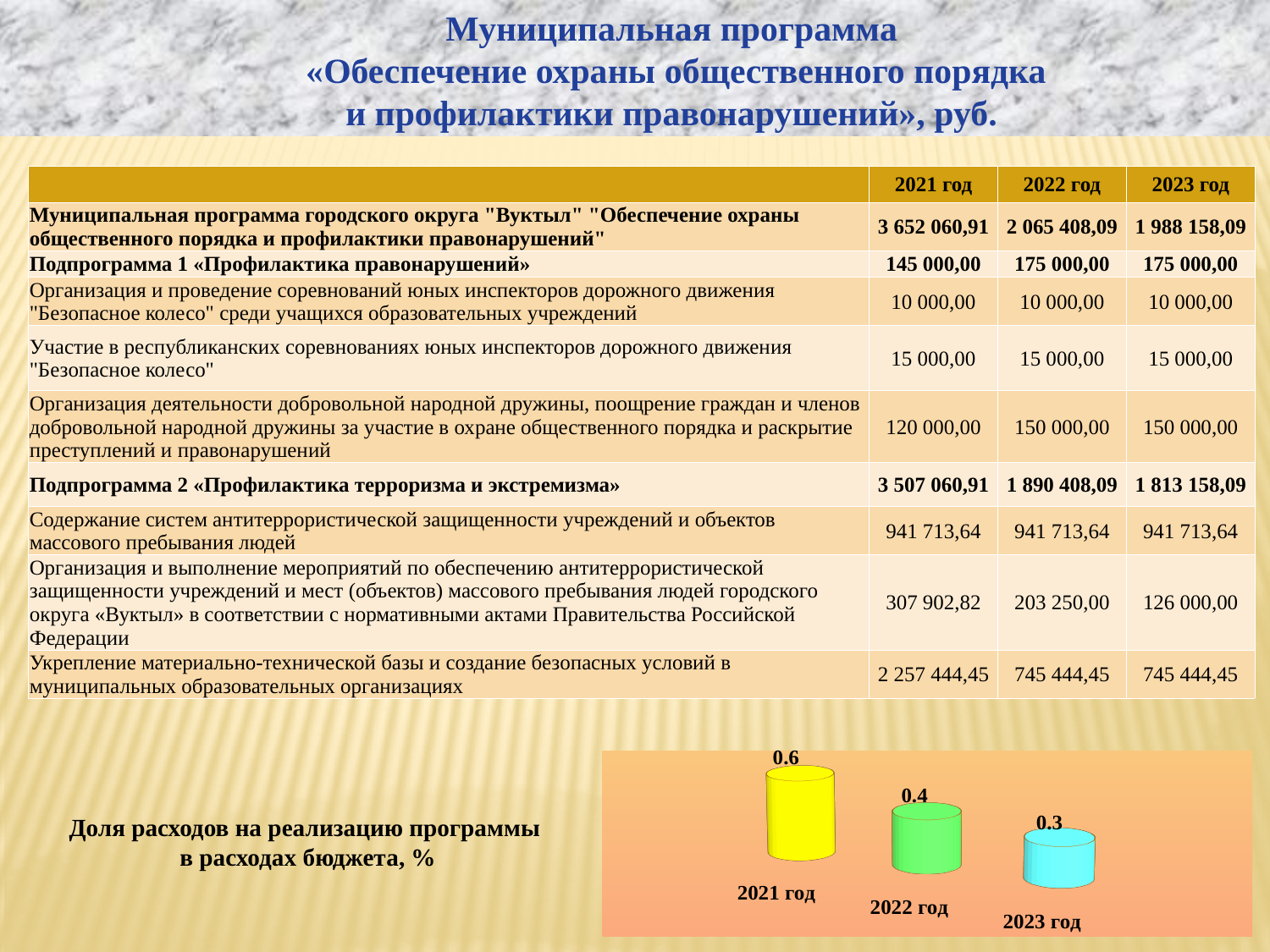
In the chart 'Доля расходов на реализацию программы в расходах бюджета, %', what is the difference between the values for 2021 год and 2022 год? 0.2 In the chart 'Доля расходов на реализацию программы в расходах бюджета, %', which year has the highest value? 2021 год What is the value shown for 2021 год in the chart 'Доля расходов на реализацию программы в расходах бюджета, %'? 0.6 In the chart 'Доля расходов на реализацию программы в расходах бюджета, %', which year has the lowest value? 2023 год What kind of chart is 'Доля расходов на реализацию программы в расходах бюджета, %'? bar chart What colour is the bar for 2021 год in the chart 'Доля расходов на реализацию программы в расходах бюджета, %'? yellow How many years (categories) are plotted in the chart 'Доля расходов на реализацию программы в расходах бюджета, %'? 3 What is the value shown for 2022 год in the chart 'Доля расходов на реализацию программы в расходах бюджета, %'? 0.4 In the chart 'Доля расходов на реализацию программы в расходах бюджета, %', which is larger: the value for 2022 год or for 2023 год? 2022 год What is the value shown for 2023 год in the chart 'Доля расходов на реализацию программы в расходах бюджета, %'? 0.3 In the chart 'Доля расходов на реализацию программы в расходах бюджета, %', do the values rise or fall from 2021 год to 2023 год? fall In the chart 'Доля расходов на реализацию программы в расходах бюджета, %', what is the difference between the values for 2021 год and 2023 год? 0.3